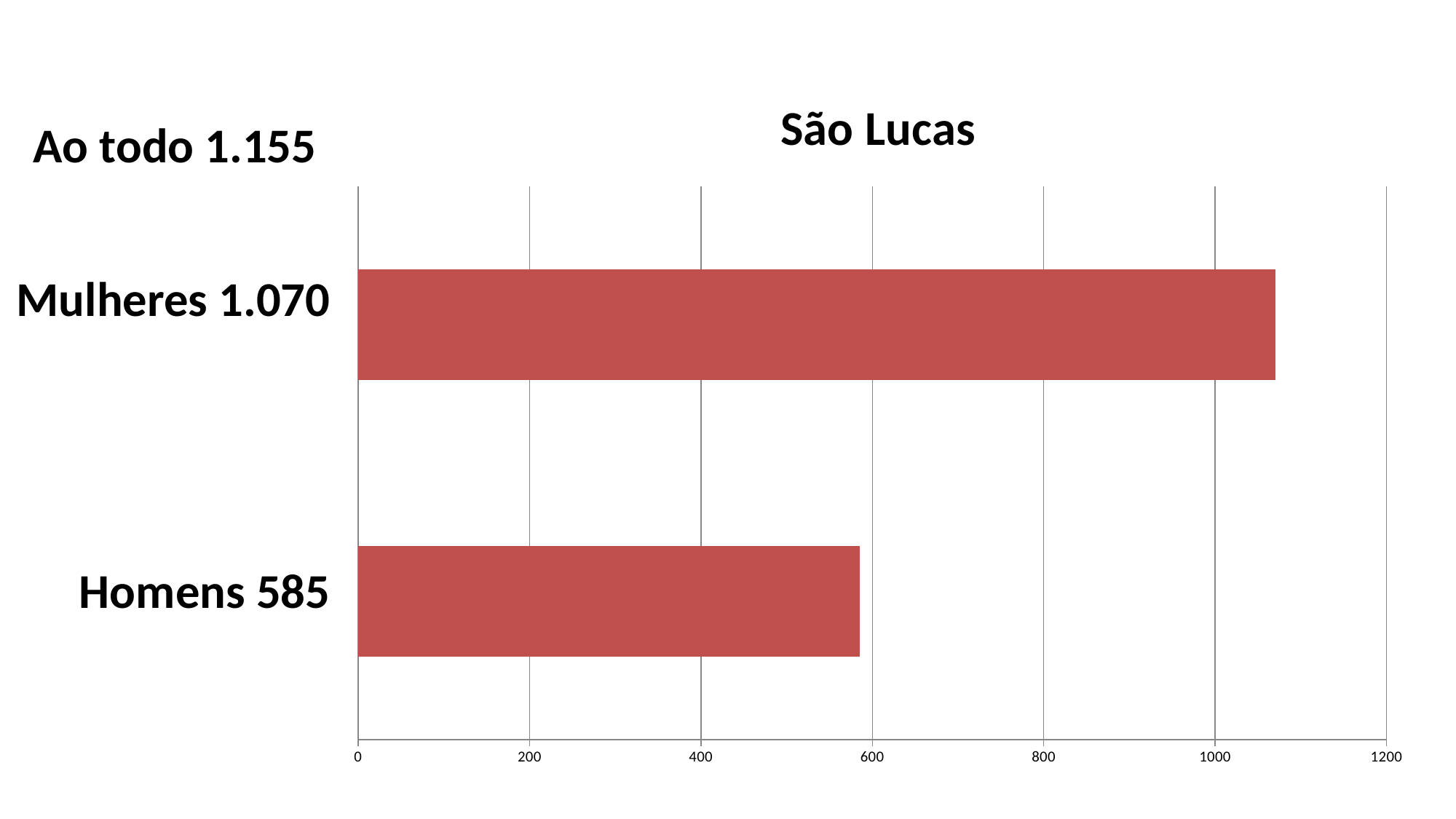
Is the value for Mulheres in the São Lucas chart greater or less than 1000? greater What is the value for Mulheres in the São Lucas chart? 1.070 How many categories are shown in the São Lucas chart? 2 Which category has the highest value in the São Lucas chart? Mulheres Which category has the lowest value in the São Lucas chart? Homens What is the difference between the values for Mulheres and Homens in the São Lucas chart? 485 What kind of chart is shown on the slide? bar chart What is the title of the chart on the slide? São Lucas Is the value for Homens in the São Lucas chart greater or less than 600? less What is the value for Homens in the São Lucas chart? 585 Which is larger in the São Lucas chart, the value for Mulheres or the value for Homens? Mulheres What is the maximum value shown on the horizontal axis of the São Lucas chart? 1200